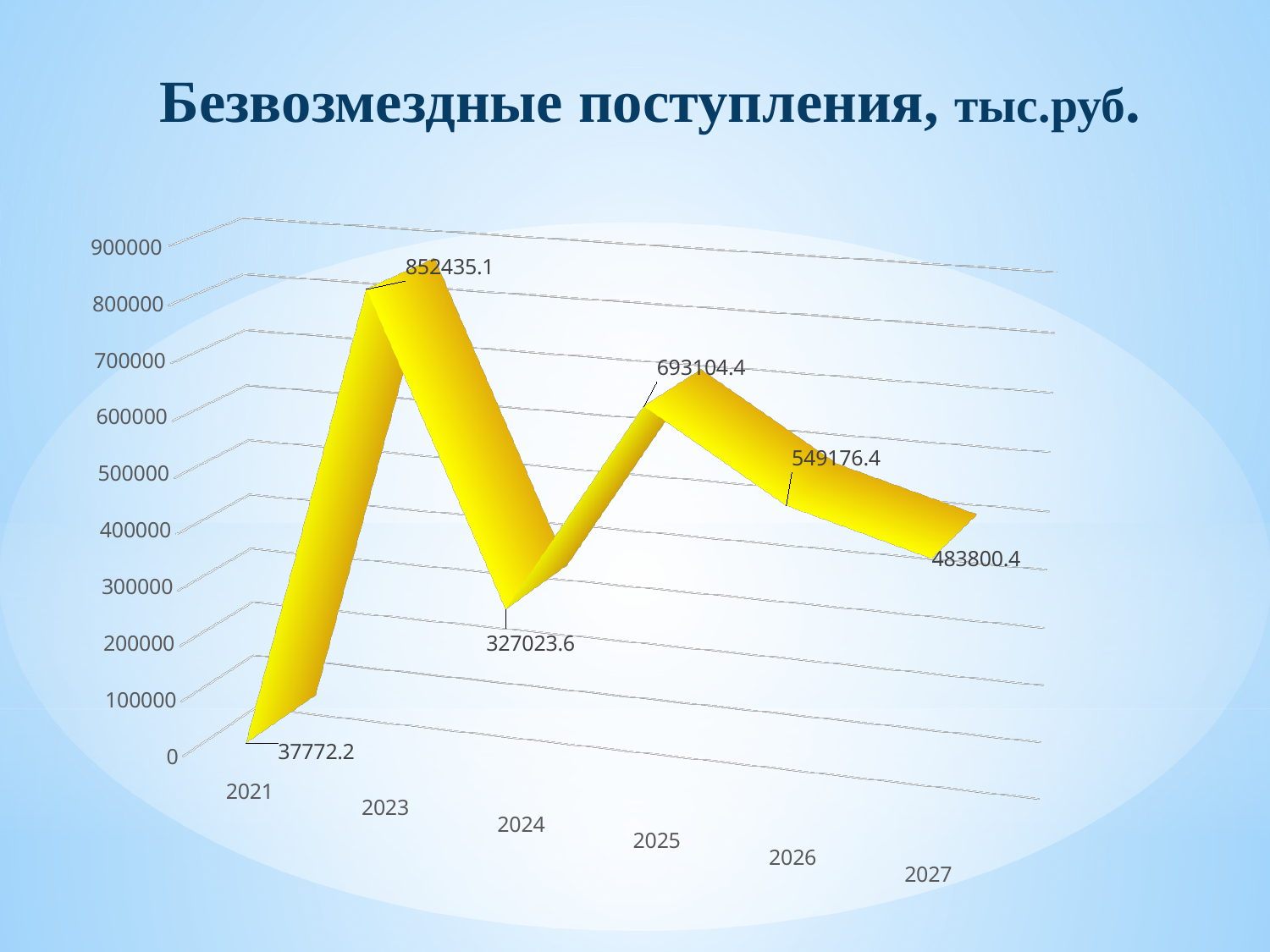
Do the values rise or fall from 2025 to 2027? fall What is the value for 2023? 852435.1 How many years are plotted on the chart? 6 What is the difference between the values for 2026 and 2027? 65376 Which is larger, the value for 2025 or the value for 2026? 2025 What is the value for 2025? 693104.4 What kind of chart is shown on the slide? line chart What is the value for 2027? 483800.4 What is the difference between the values for 2023 and 2024? 525411.5 Which year has the highest value? 2023 Which year has the lowest value? 2021 What is the value for 2021? 37772.2